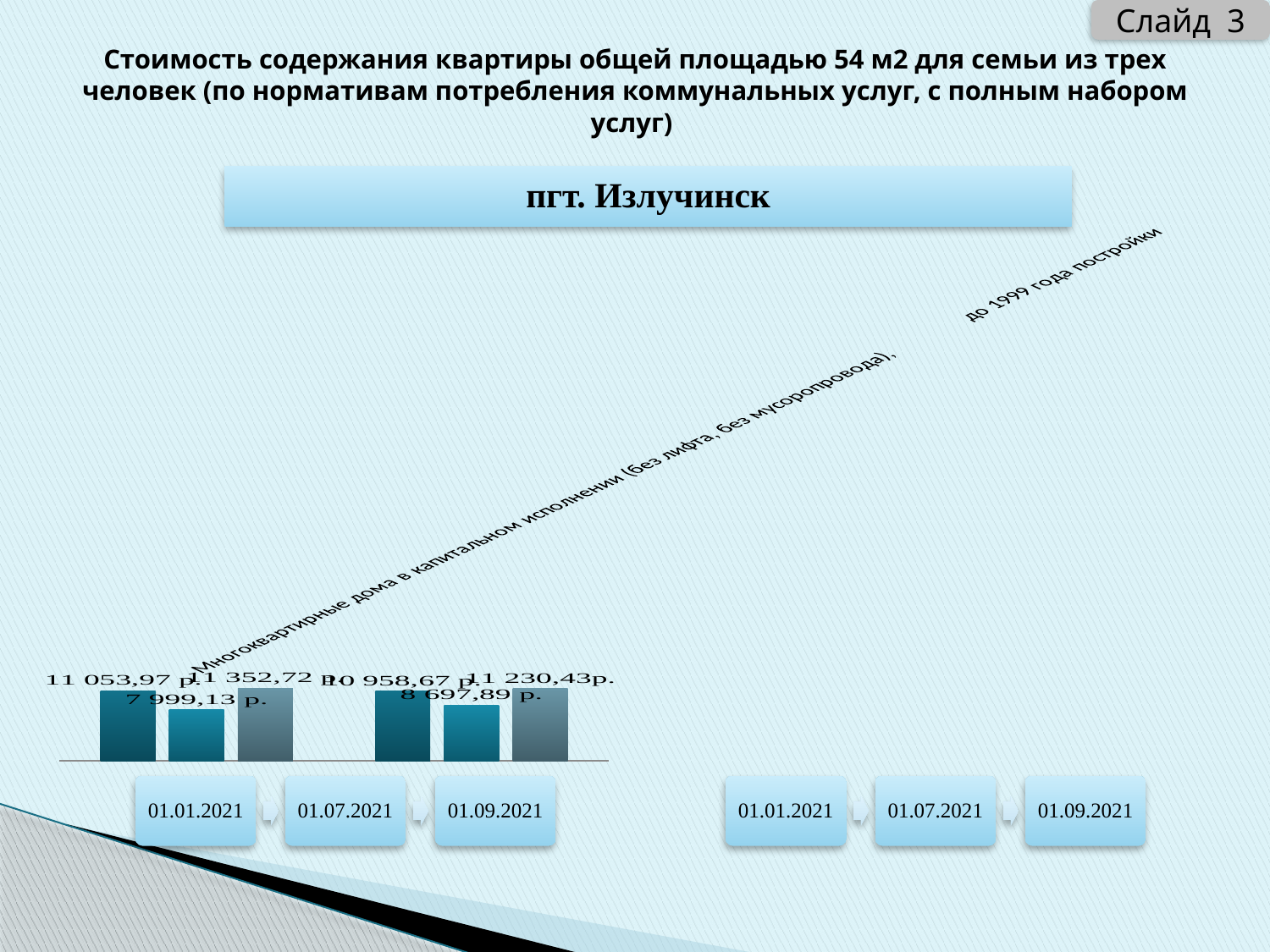
What is the value of the middle (01.07.2021) bar in the left group of the chart? 7 999,13 р. How many bars are plotted in the chart? 6 What is the value of the first (01.01.2021) bar in the left group of the chart? 11 053,97 р. What is the value of the third (01.09.2021) bar in the left group of the chart? 11 352,72 р. Which bar has the lowest value in the chart? 7 999,13 р. (01.07.2021, left group) Which is larger: the 01.07.2021 bar in the left group or the 01.07.2021 bar in the right group? the right group (8 697,89 р.) How many category groups of bars does the chart have? 2 What is the difference between the 01.09.2021 bar and the 01.01.2021 bar in the left group? 298,75 р. What kind of chart is shown on the slide? bar chart